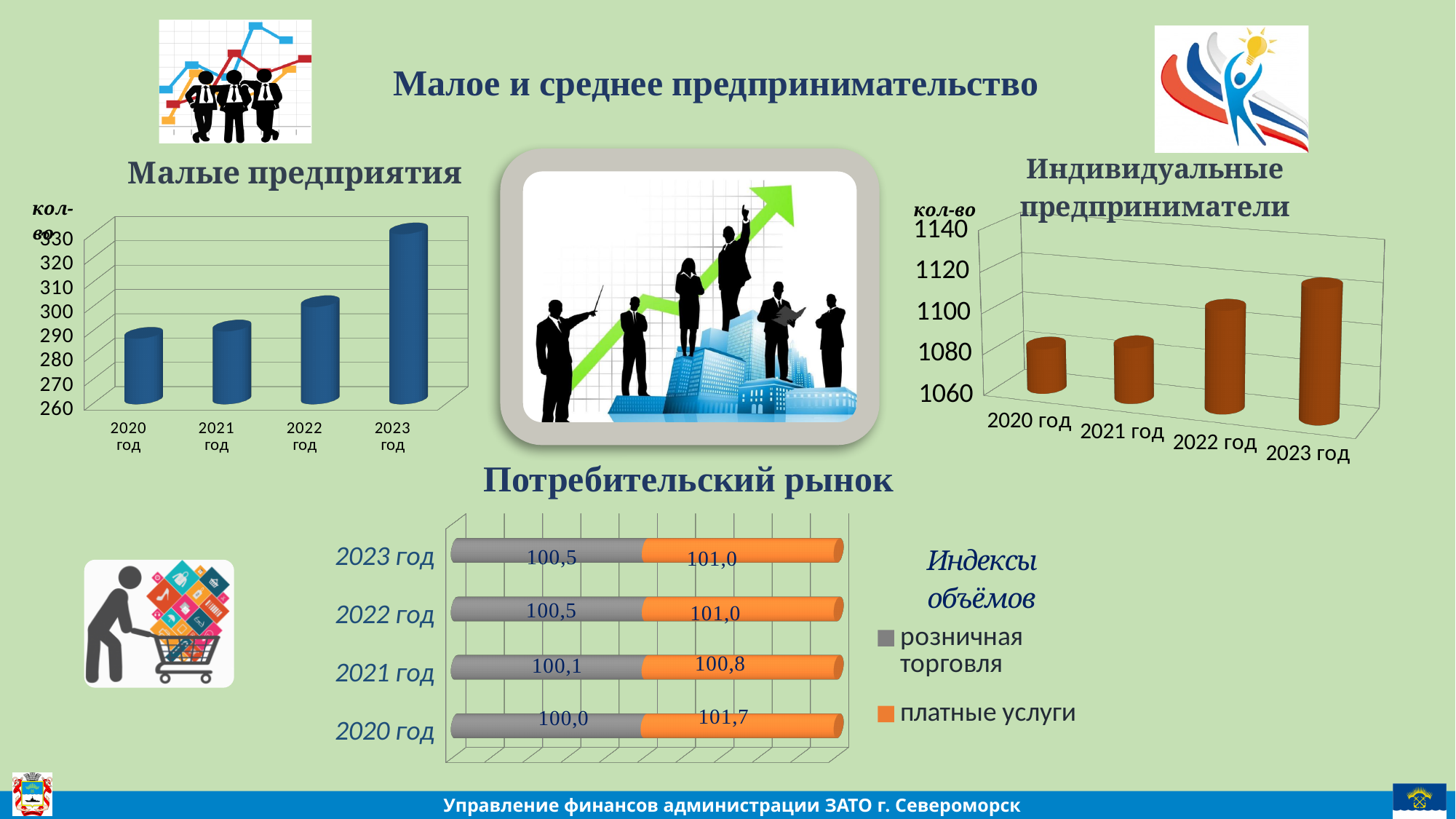
On the 'Малые предприятия' chart, is the value for 2023 год greater or less than 320? greater On the 'Потребительский рынок' chart, how many series does the legend list? 2 On the 'Малые предприятия' chart, is the value for 2020 год greater or less than 300? less On the 'Потребительский рынок' chart, what is the difference between платные услуги in 2020 год and 2021 год? 0,9 On the 'Потребительский рынок' chart, what is the value of розничная торговля for 2021 год? 100,1 On the 'Индивидуальные предприниматели' chart, how many years are shown? 4 On the 'Индивидуальные предприниматели' chart, is the value for 2020 год greater or less than 1100? less On the 'Потребительский рынок' chart, what is the total of the stacked bar for 2023 год? 201,5 On the 'Индивидуальные предприниматели' chart, which year has the highest value? 2023 год On the 'Малые предприятия' chart, do the values rise or fall from 2020 to 2023? rise On the 'Малые предприятия' chart, which year has the highest value? 2023 год On the 'Потребительский рынок' chart, what is the value of платные услуги for 2020 год? 101,7